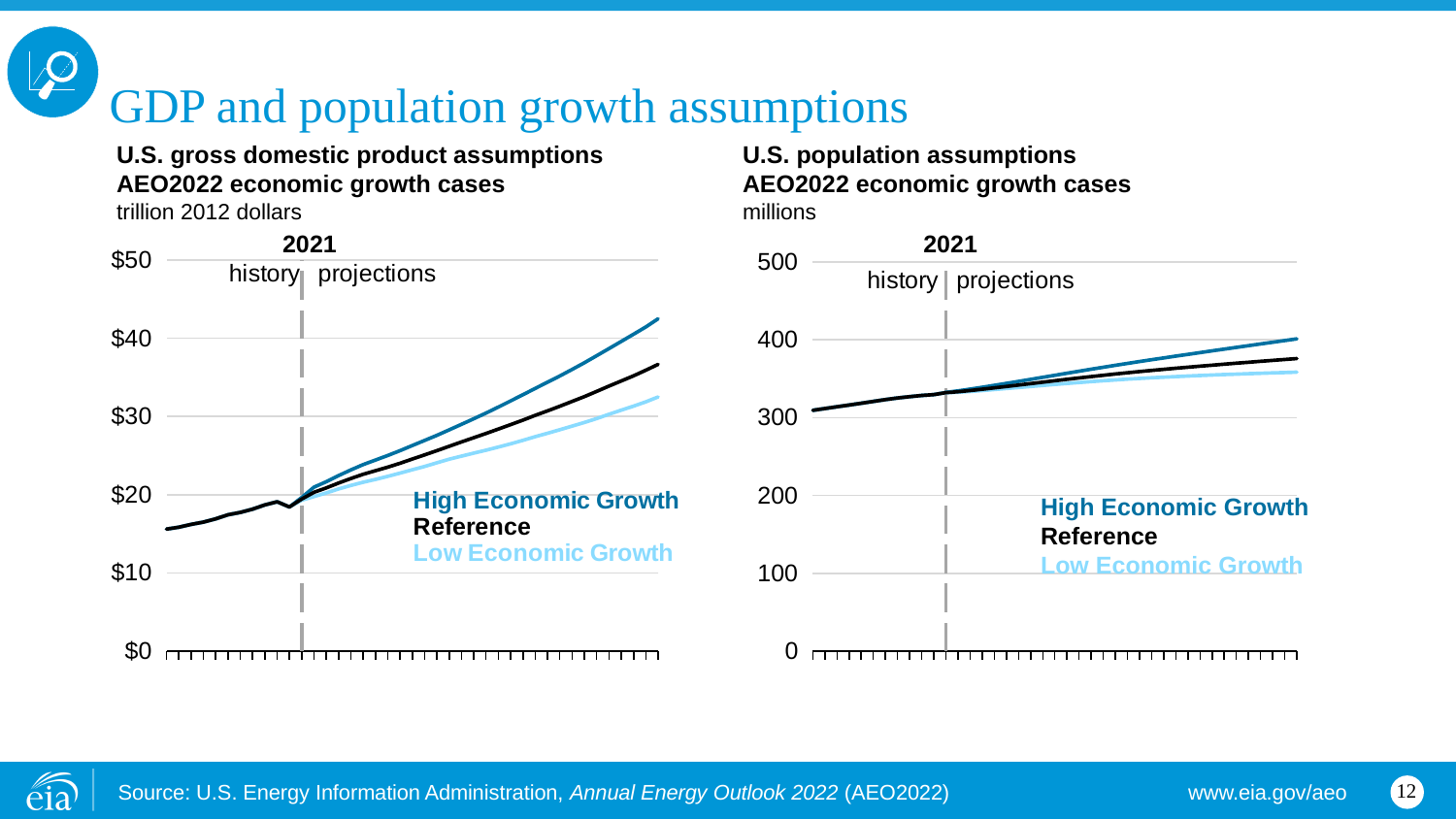
What kind of chart is the U.S. gross domestic product assumptions chart? line chart In the U.S. gross domestic product assumptions chart, is the first historical value greater or less than $20? less How many series does the U.S. population assumptions chart show? 3 In the U.S. gross domestic product assumptions chart, which series ends higher at the end of the projection period, High Economic Growth or Low Economic Growth? High Economic Growth In the U.S. gross domestic product assumptions chart, is the final projected value for High Economic Growth greater or less than $40? greater In the U.S. population assumptions chart, does the Low Economic Growth series rise or fall over the projection period? rise What unit is used on the U.S. gross domestic product assumptions chart? trillion 2012 dollars In the U.S. gross domestic product assumptions chart, does the Reference series rise or fall over the projection period? rise In the U.S. gross domestic product assumptions chart, is the final projected value for Low Economic Growth greater or less than $40? less What year separates history from projections in both charts? 2021